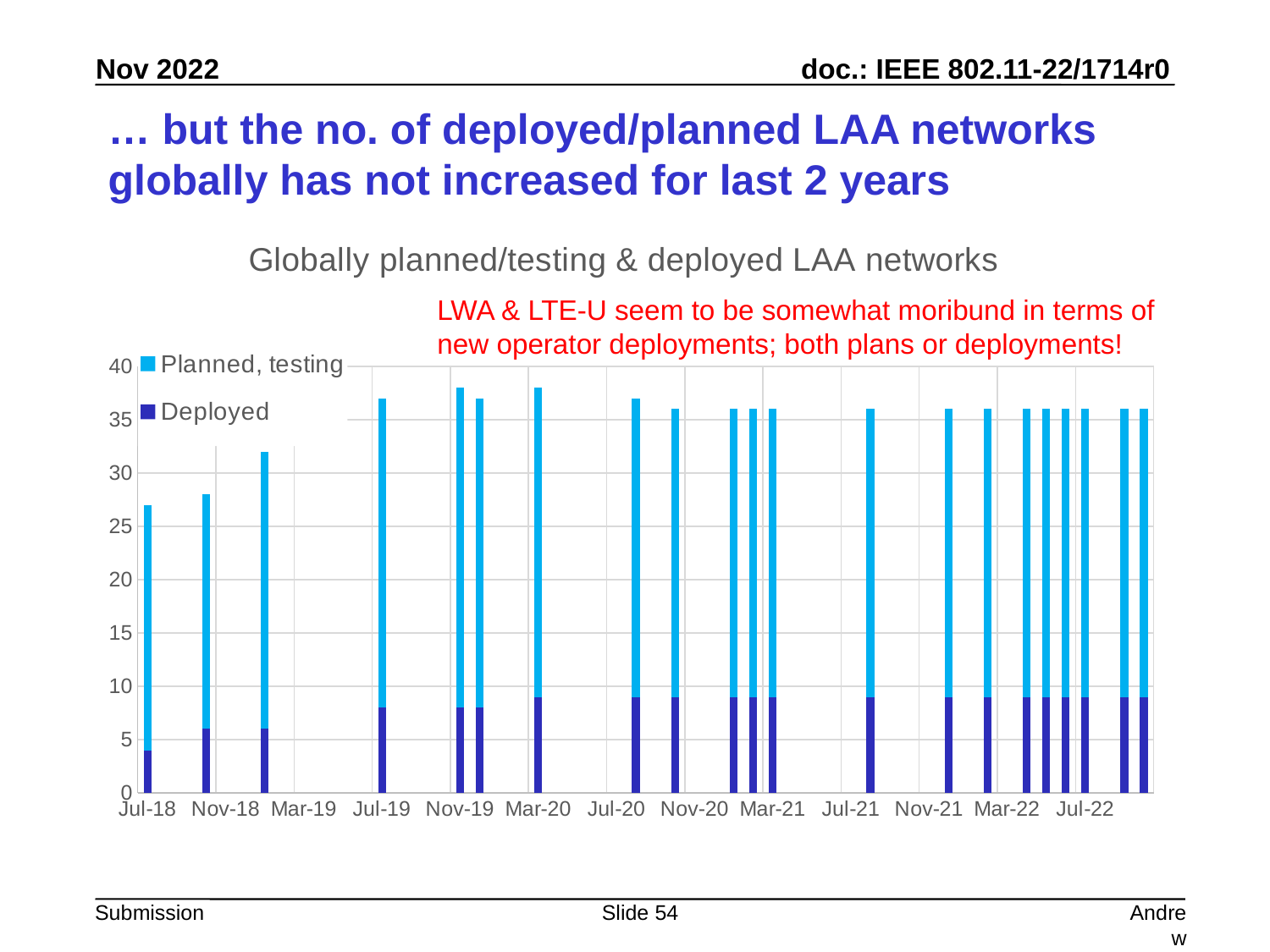
Is the total height of the bar at Jul-19 greater or less than 35? greater Do the total bar heights rise or fall from Jul-18 to Jul-19? rise Which series is shown in dark blue in the chart? Deployed Is the total height of the bar at Nov-18 greater or less than 30? less Is the Deployed value at Jul-22 greater or less than 10? less What kind of chart is shown on the slide? stacked bar chart How many series does the chart legend list? 2 Which is larger, the total bar at Jul-18 or the total bar at Jul-19? Jul-19 What is the title of the chart? Globally planned/testing & deployed LAA networks